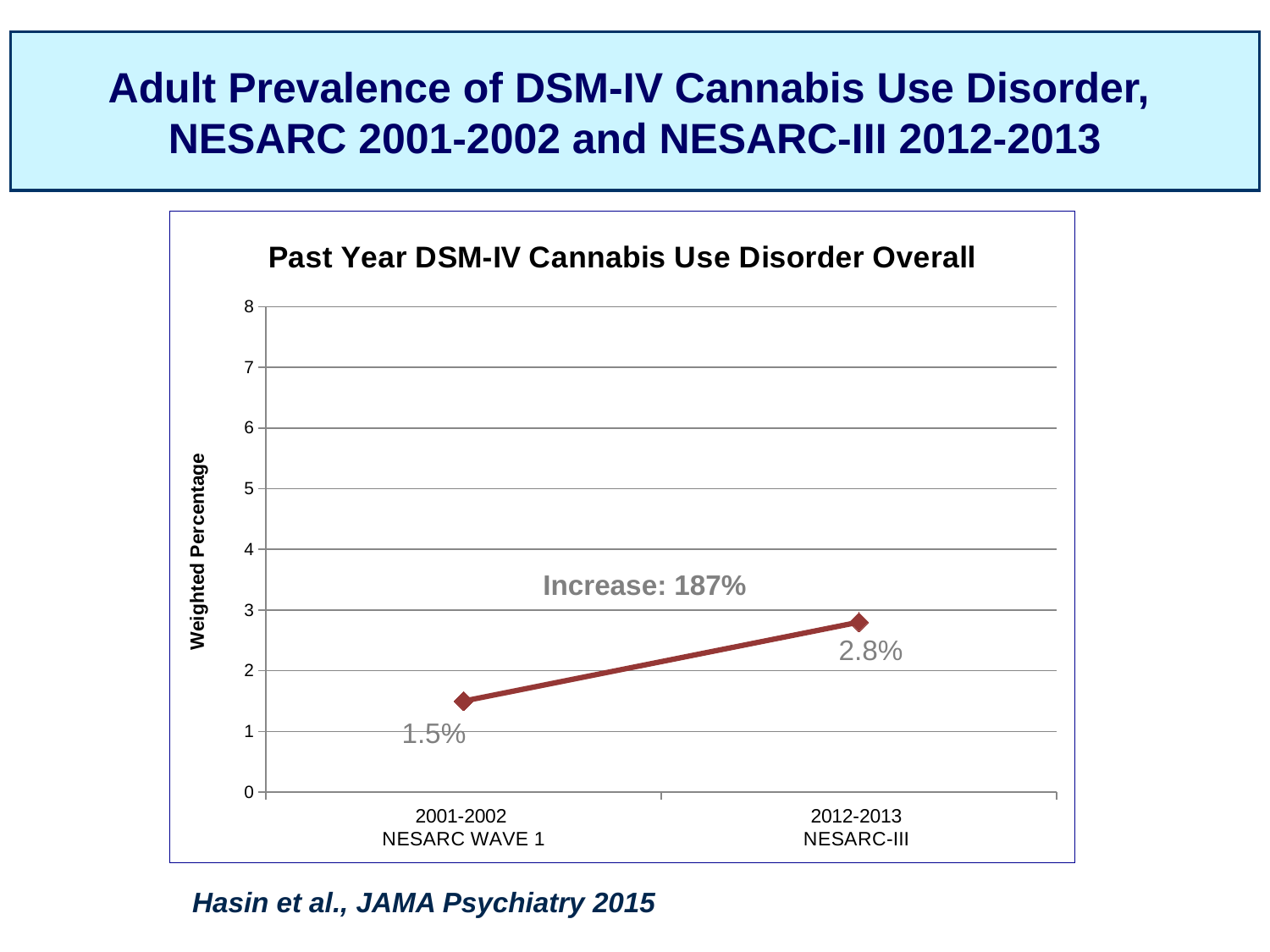
What is the title of the chart? Past Year DSM-IV Cannabis Use Disorder Overall What percentage increase is annotated on the chart? 187% Does the prevalence rise or fall from 2001-2002 to 2012-2013? Rise Which survey wave has the lower past year cannabis use disorder prevalence? 2001-2002 NESARC WAVE 1 What kind of chart is shown on the slide? Line chart How many data points are plotted on the chart? 2 Is the value for 2001-2002 NESARC WAVE 1 greater or less than 1? greater What is the weighted percentage for 2001-2002 NESARC WAVE 1? 1.5% What is the difference in weighted percentage between 2012-2013 NESARC-III and 2001-2002 NESARC WAVE 1? 1.3% Is the value for 2012-2013 NESARC-III greater or less than 3? less Which survey wave has the higher past year cannabis use disorder prevalence? 2012-2013 NESARC-III What is the weighted percentage for 2012-2013 NESARC-III? 2.8%